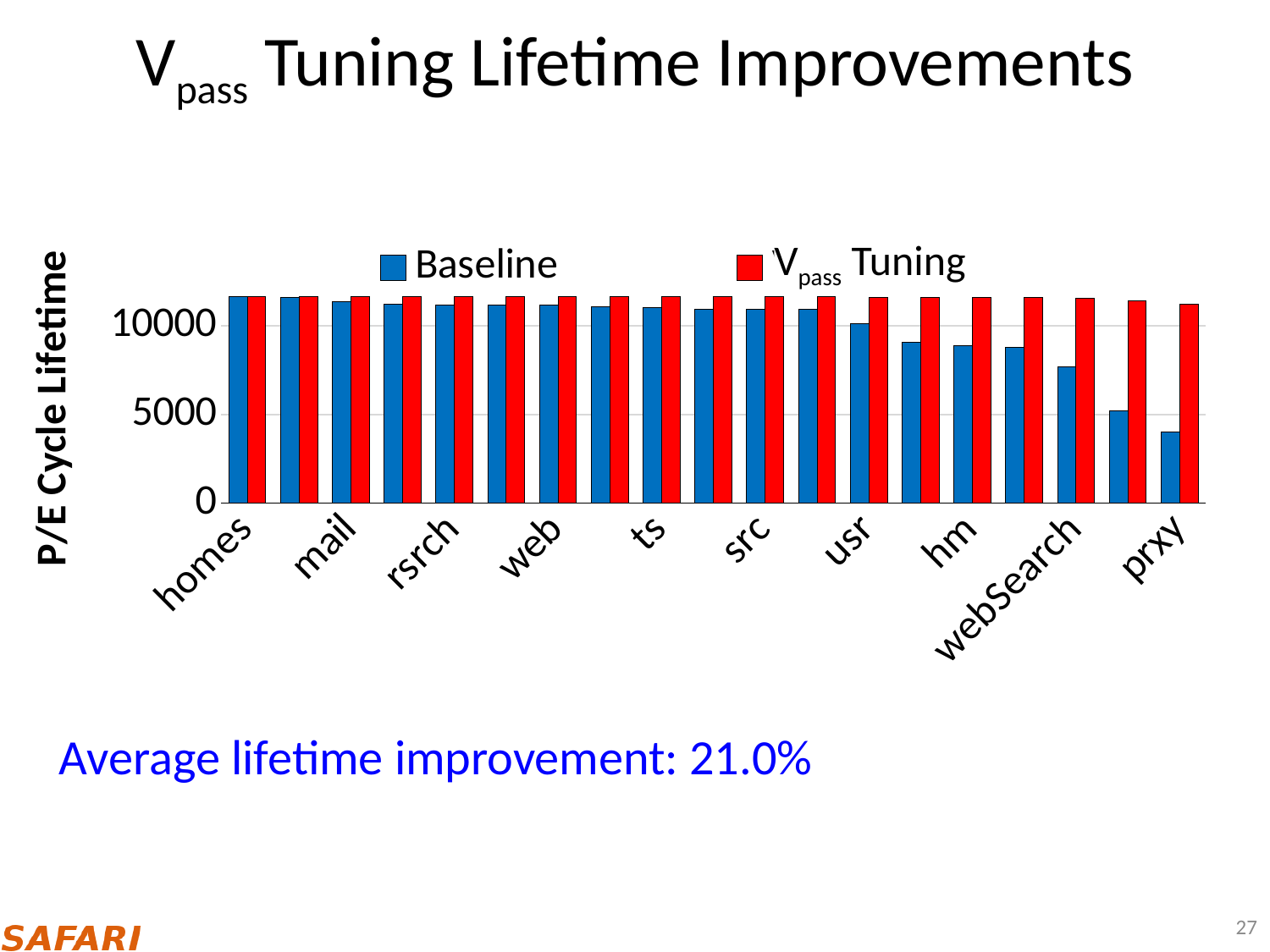
Is the Baseline value for webSearch greater or less than 5000? greater What colour are the Baseline bars? blue What kind of chart is shown on the slide? bar chart Which category has the lowest Baseline value? prxy How many series does the legend list? 2 Is the Baseline value for hm greater or less than 10000? less Is the Baseline value for prxy greater or less than 5000? less Do the Baseline values rise or fall moving from homes to prxy along the x axis? fall For prxy, which is larger: the Baseline value or the Vpass Tuning value? Vpass Tuning What is the label of the y axis? P/E Cycle Lifetime